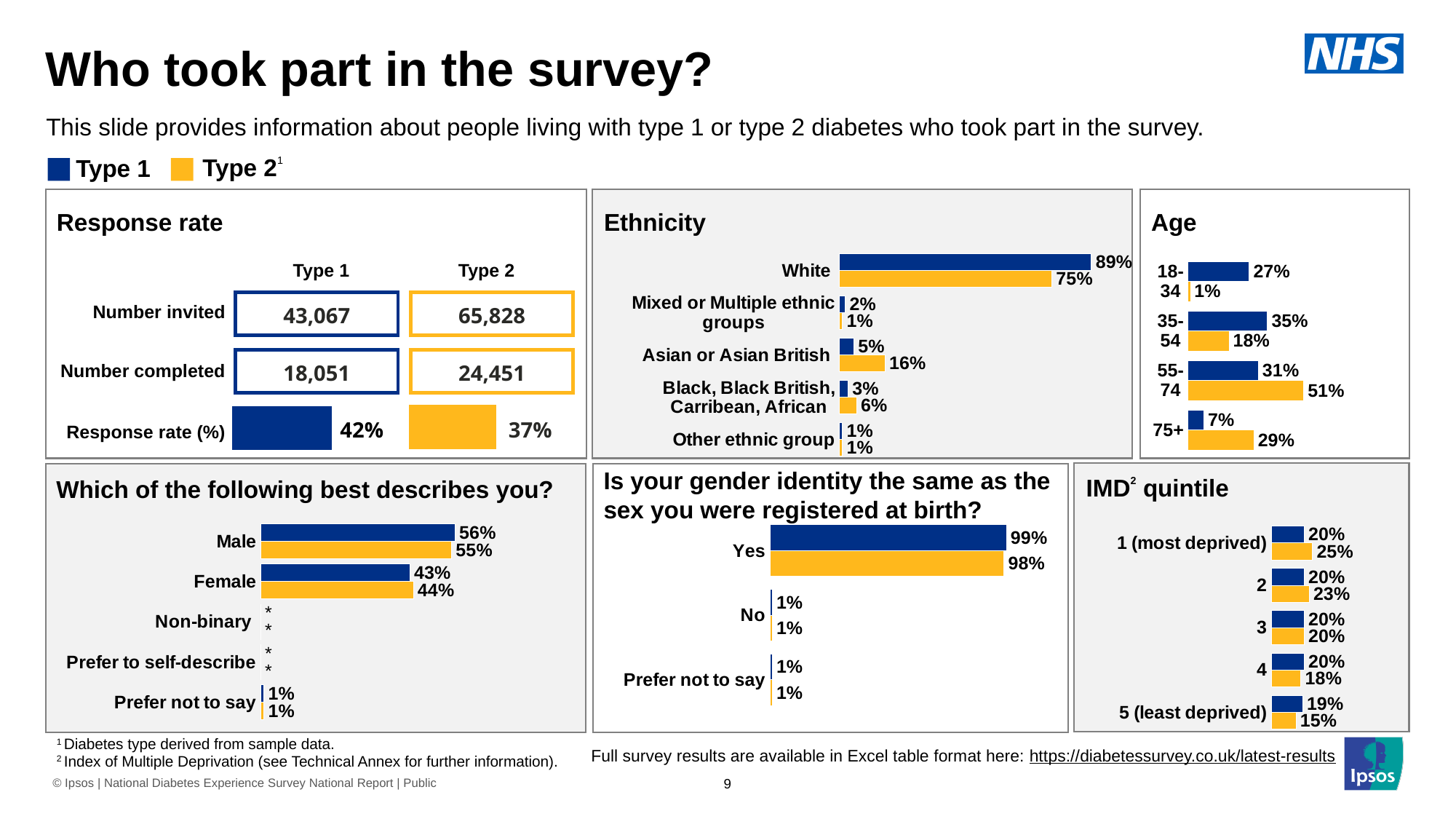
In the Ethnicity chart, what percentage of Type 2 respondents are White? 75% In the Age chart, what is the difference between the Type 1 and Type 2 percentages for the 75+ group? 22% In the IMD quintile chart, which quintile has the lowest Type 2 percentage? 5 (least deprived) In the gender identity chart, what percentage of Type 2 respondents answered Yes? 98% In the 'Which of the following best describes you?' chart, what percentage of Type 1 respondents are Female? 43% What type of chart is the Ethnicity chart? bar chart In the 'Which of the following best describes you?' chart, is the Type 1 value for Male larger or smaller than the Type 2 value for Male? larger In the IMD quintile chart, how many quintile categories are shown? 5 In the Ethnicity chart, what percentage of Type 1 respondents are Asian or Asian British? 5% In the Response rate chart, what is the response rate for Type 1? 42% In the Response rate chart, how many people with Type 2 diabetes completed the survey? 24,451 In the Age chart, which age group has the highest Type 2 percentage? 55-74